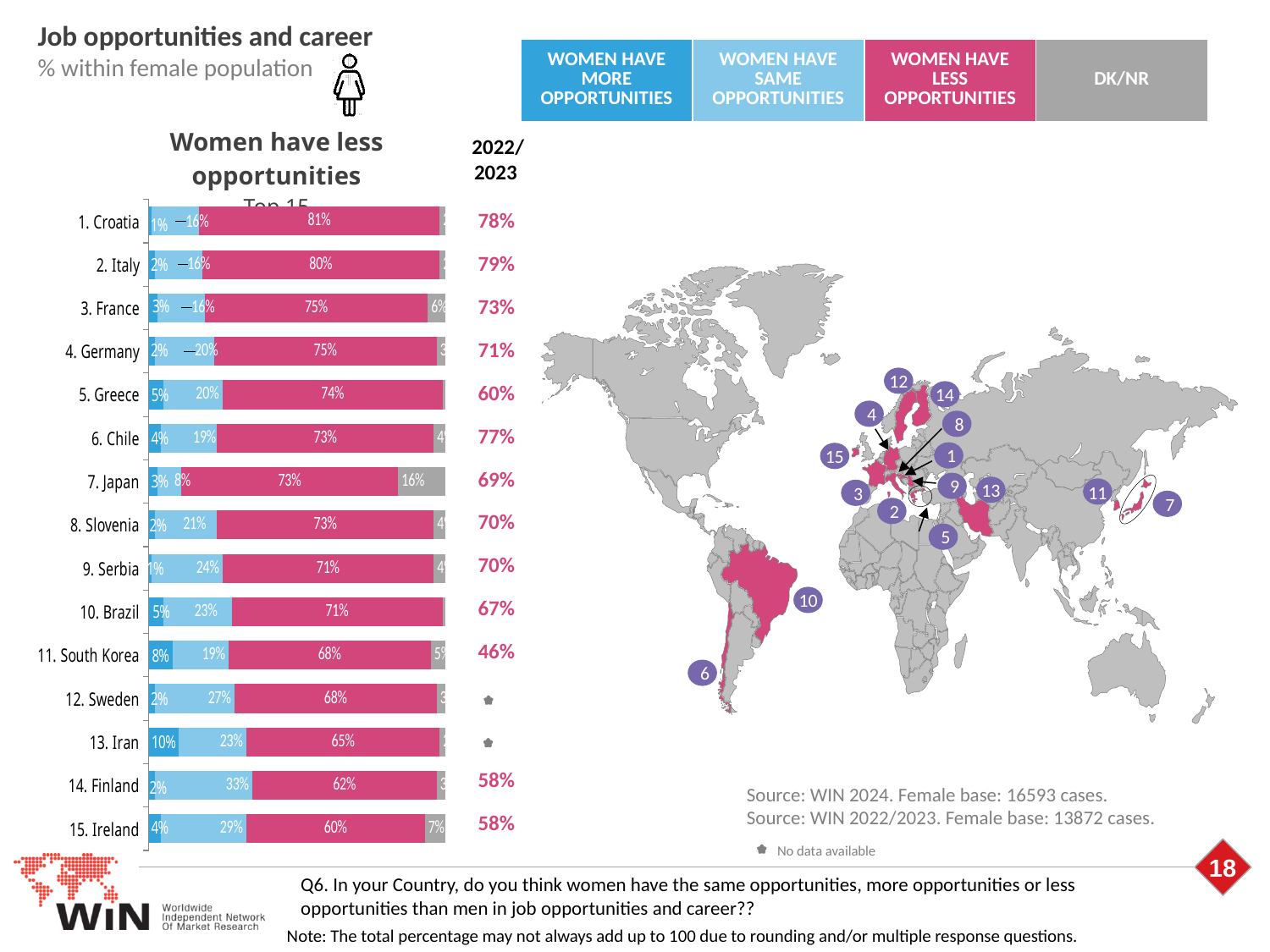
What is the difference between the 'women have less opportunities' values for Italy and Ireland? 20% Which colour represents 'women have less opportunities' in the chart? Pink Which has a larger 'women have more opportunities' value, Iran or South Korea? Iran How many countries are shown in the bar chart? 15 What percentage of women in Croatia say women have less opportunities? 81% What is the DK/NR value for Japan? 16% Which country has the highest 'women have less opportunities' value? Croatia How many response categories does the legend list? 4 What is the 'women have same opportunities' value for Finland? 33% What type of chart is used to show the country results? Stacked bar chart What was the 2022/2023 value for South Korea? 46% Which of the 15 countries has the lowest 'women have less opportunities' value? Ireland